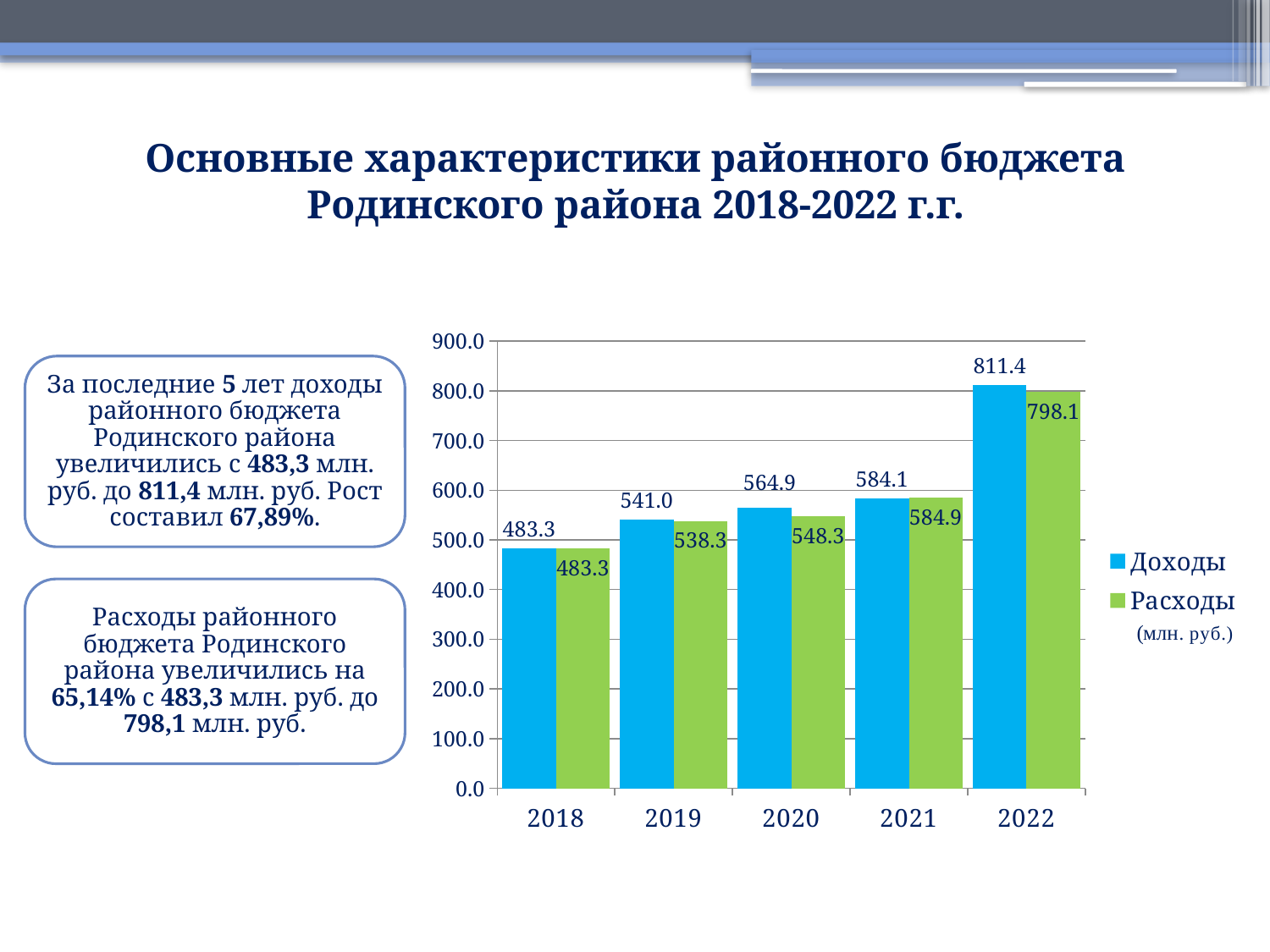
In which year is Расходы lowest? 2018 In which year is Доходы highest? 2022 What is the value of Доходы for 2020? 564.9 What is the difference between Доходы and Расходы in 2022? 13.3 How many years are shown on the x axis? 5 How many series does the legend list? 2 What is the value of Расходы for 2019? 538.3 Do the Доходы values rise or fall from 2018 to 2022? rise What is the difference between Доходы in 2022 and Доходы in 2018? 328.1 What kind of chart is shown on the slide? bar chart Which is larger in 2021: Доходы or Расходы? Расходы What is the value of Расходы for 2021? 584.9